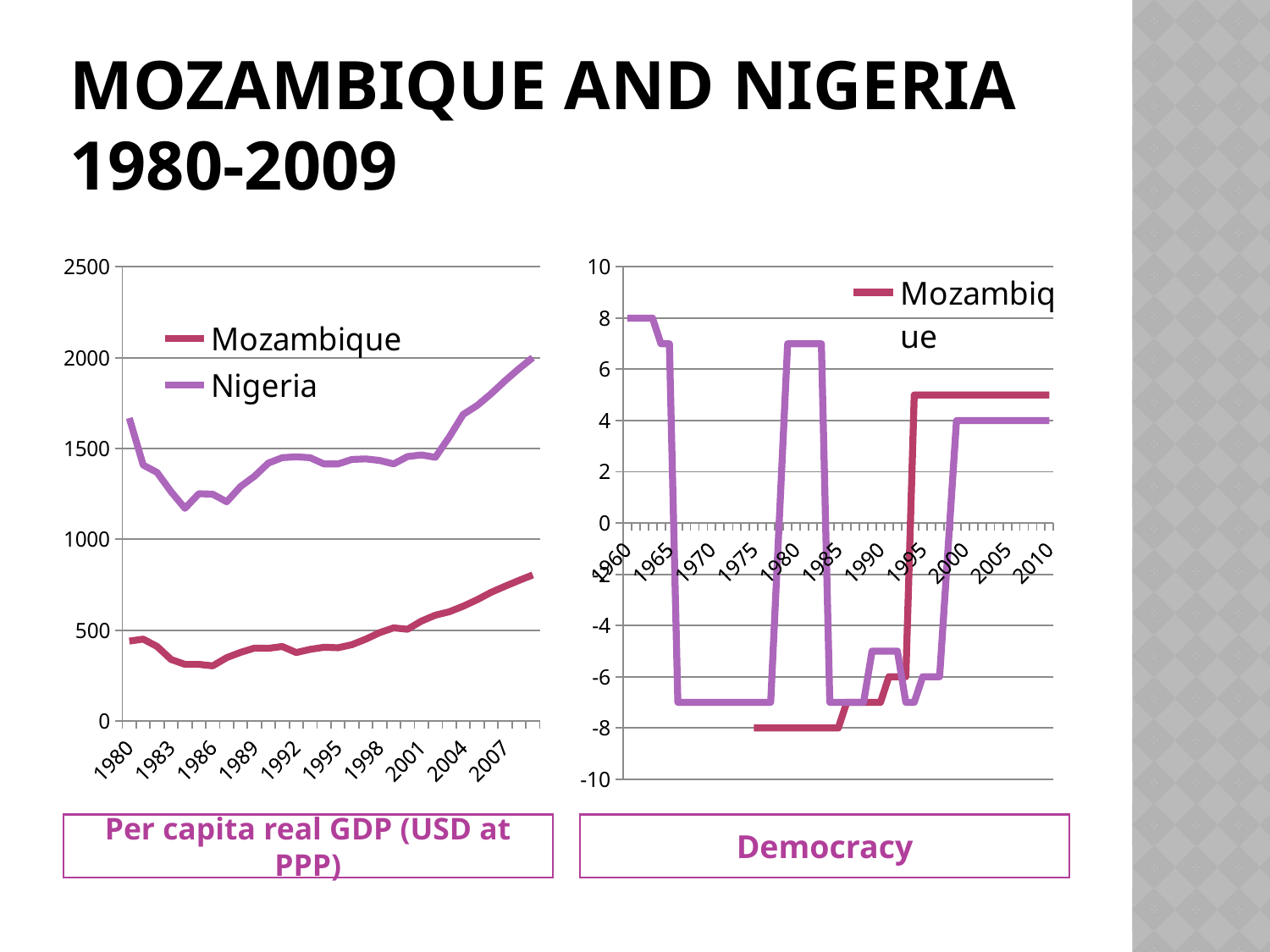
In the Per capita real GDP (USD at PPP) chart, is the value for Nigeria in 2007 greater or less than 1500? greater In the Democracy chart, what is the value for Mozambique in 1980? -8 In the Democracy chart, what is the value for Nigeria in 2010? 4 In the Per capita real GDP (USD at PPP) chart, which country has the higher value in 1980? Nigeria In the Per capita real GDP (USD at PPP) chart, does the Mozambique line rise or fall between 1995 and 2009? rise In the Democracy chart, is the value for Nigeria in 1970 greater or less than -6? less How many series does the legend of the Per capita real GDP (USD at PPP) chart list? 2 In the Per capita real GDP (USD at PPP) chart, is the value for Mozambique in 1980 greater or less than 500? less What kind of chart is the Democracy chart? line chart In the Democracy chart, which country has the higher value in 2005? Mozambique What kind of chart is the Per capita real GDP (USD at PPP) chart? line chart